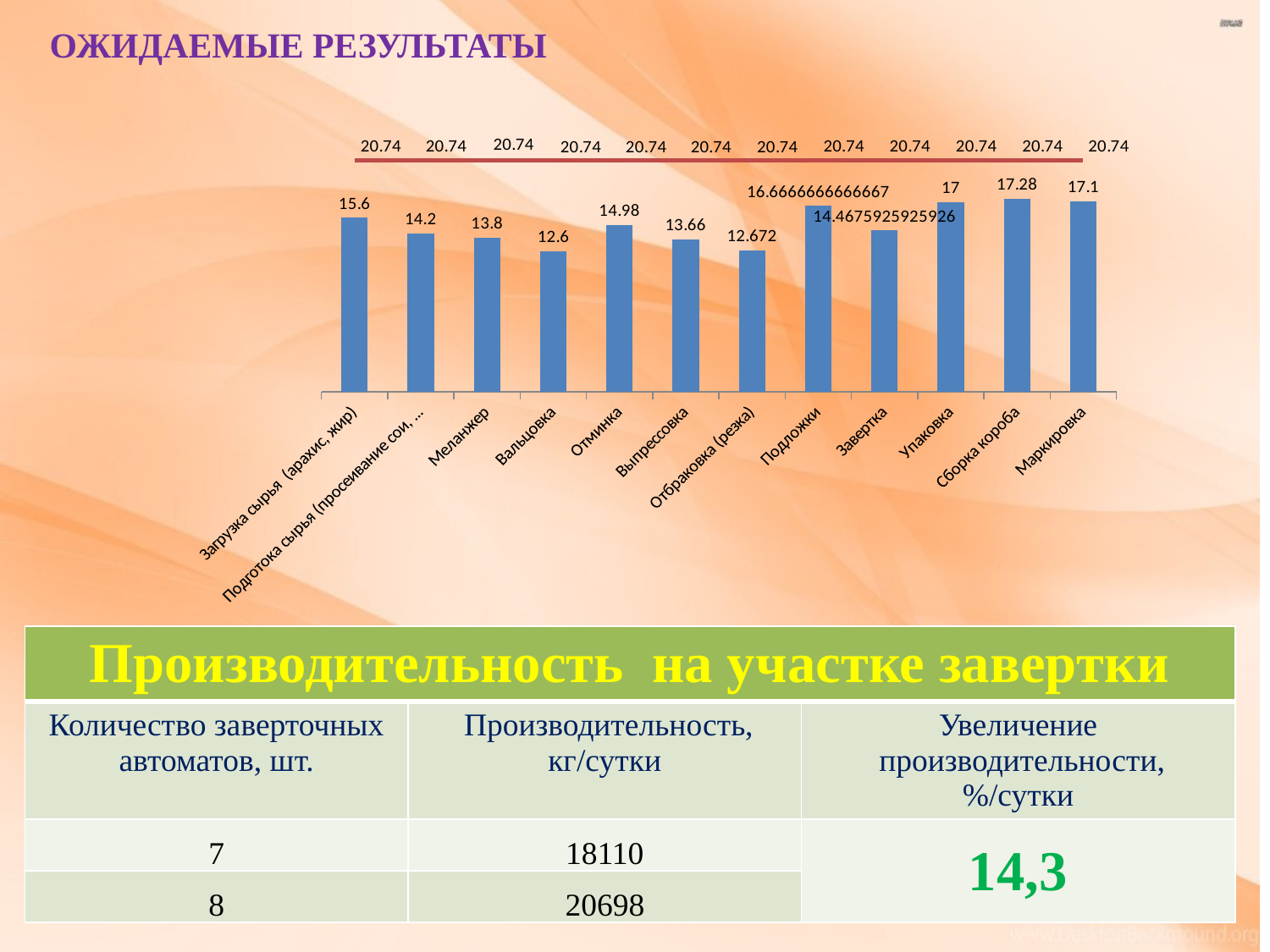
What is the difference between the bar values for Маркировка and Упаковка? 0.1 How many categories are plotted on the x axis of the chart? 12 Which category has the lowest bar? Вальцовка What is the value of the bar for Упаковка? 17 What type of chart is shown on the slide? combination bar and line chart Which category has the highest bar? Сборка короба What is the value of the bar for Отминка? 14.98 What constant value does the red line across the top of the chart show? 20.74 Which bar is taller, Загрузка сырья (арахис, жир) or Выпрессовка? Загрузка сырья (арахис, жир) What is the value of the bar for Отбраковка (резка)? 12.672 What is the value of the bar for Меланжер? 13.8 What is the difference between the bar values for Сборка короба and Вальцовка? 4.68